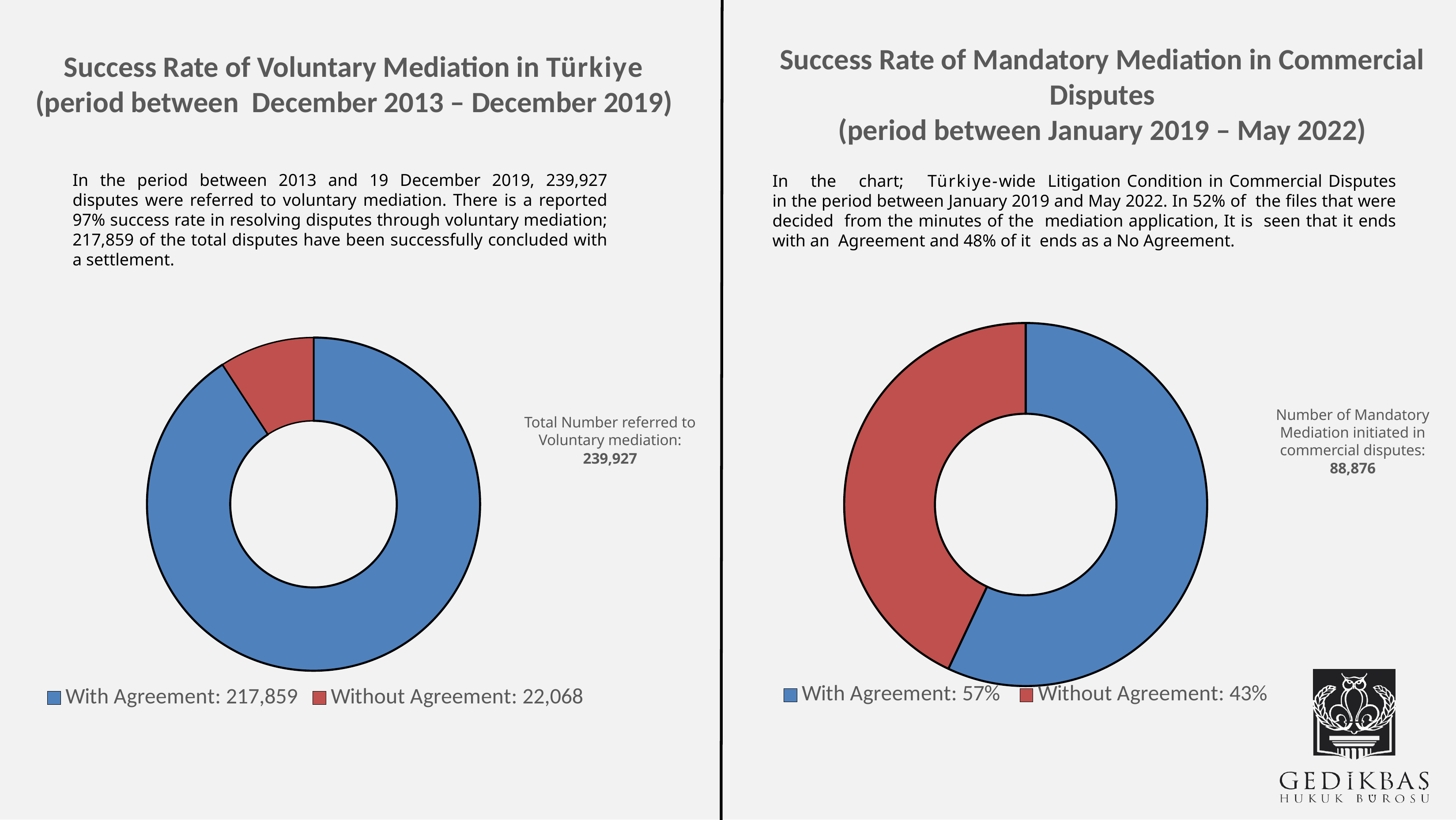
In the right chart (Success Rate of Mandatory Mediation in Commercial Disputes), what is the number of mandatory mediations initiated in commercial disputes? 88,876 In the left chart (Success Rate of Voluntary Mediation in Türkiye), what is the value for With Agreement? 217,859 In the right chart (Success Rate of Mandatory Mediation in Commercial Disputes), what is the value for Without Agreement? 43% In the left chart (Success Rate of Voluntary Mediation in Türkiye), what colour represents Without Agreement? Red How many categories does the legend of the right chart (Success Rate of Mandatory Mediation in Commercial Disputes) list? 2 In the right chart (Success Rate of Mandatory Mediation in Commercial Disputes), what share of the pie is With Agreement? 57% In the right chart (Success Rate of Mandatory Mediation in Commercial Disputes), which category is the smallest? Without Agreement In the left chart (Success Rate of Voluntary Mediation in Türkiye), which category is the largest? With Agreement In the left chart (Success Rate of Voluntary Mediation in Türkiye), what is the difference between With Agreement and Without Agreement? 195,791 In the left chart (Success Rate of Voluntary Mediation in Türkiye), what is the value for Without Agreement? 22,068 In the left chart (Success Rate of Voluntary Mediation in Türkiye), what is the total number referred to voluntary mediation? 239,927 What kind of chart is shown on the left side of the slide? Donut (pie) chart